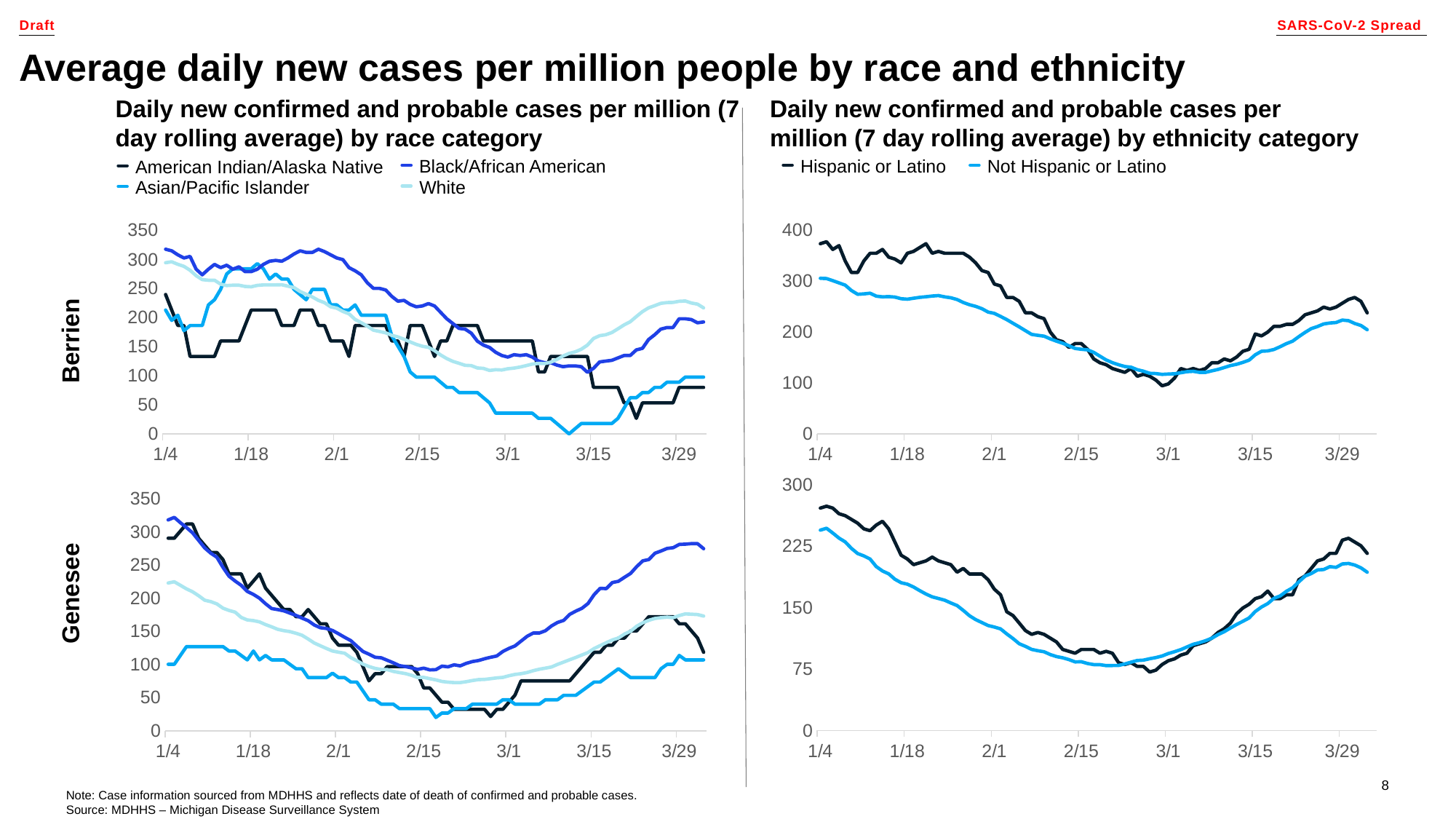
What kind of chart is the Berrien chart by race category? line chart In the Berrien chart by ethnicity category, which series has the higher value on 1/4, Hispanic or Latino or Not Hispanic or Latino? Hispanic or Latino In the Genesee chart by race category, is the value for Black/African American on 1/4 greater or less than 300? greater In the Genesee chart by ethnicity category, is the value for Hispanic or Latino on 1/4 greater or less than 225? greater In the Genesee chart by race category, which series has the higher value on 1/4, Black/African American or Asian/Pacific Islander? Black/African American Which two counties are the charts on the slide labelled with? Berrien and Genesee In the Berrien chart by ethnicity category, is the value for Hispanic or Latino on 1/4 greater or less than 300? greater How many series does the legend of the race category charts list? 4 In the Berrien chart by ethnicity category, does the Hispanic or Latino line rise or fall from 1/4 to 3/1? fall How many series does the legend of the ethnicity category charts list? 2 In the Genesee chart by race category, does the Black/African American line rise or fall from 3/1 to 3/29? rise